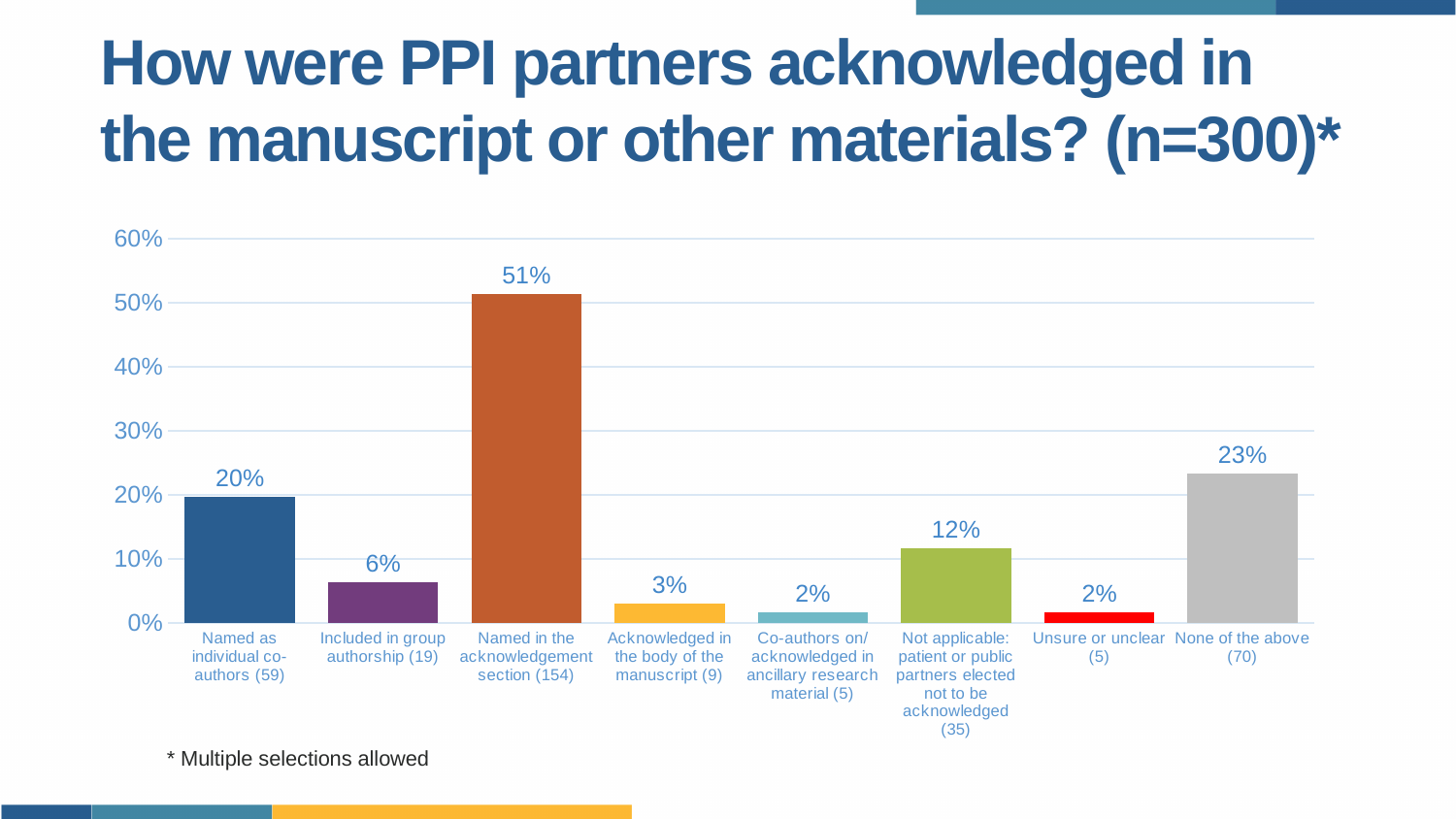
What percentage of respondents said PPI partners were included in group authorship? 6% How many respondents selected 'Not applicable: patient or public partners elected not to be acknowledged', according to the category label? 35 Which is larger: the percentage for 'Named as individual co-authors' or for 'Not applicable: patient or public partners elected not to be acknowledged'? Named as individual co-authors Which category has the highest percentage? Named in the acknowledgement section (154) What is the difference in percentage points between 'Named in the acknowledgement section' and 'None of the above'? 28 What percentage of respondents said PPI partners were named as individual co-authors? 20% What percentage of respondents said PPI partners were named in the acknowledgement section? 51% Is the value for 'Named in the acknowledgement section' greater or less than 50%? greater What percentage of respondents selected 'None of the above'? 23% What is the total sample size given in the chart title? n=300 What kind of chart is shown on the slide? Bar chart How many categories are shown on the x axis? 8